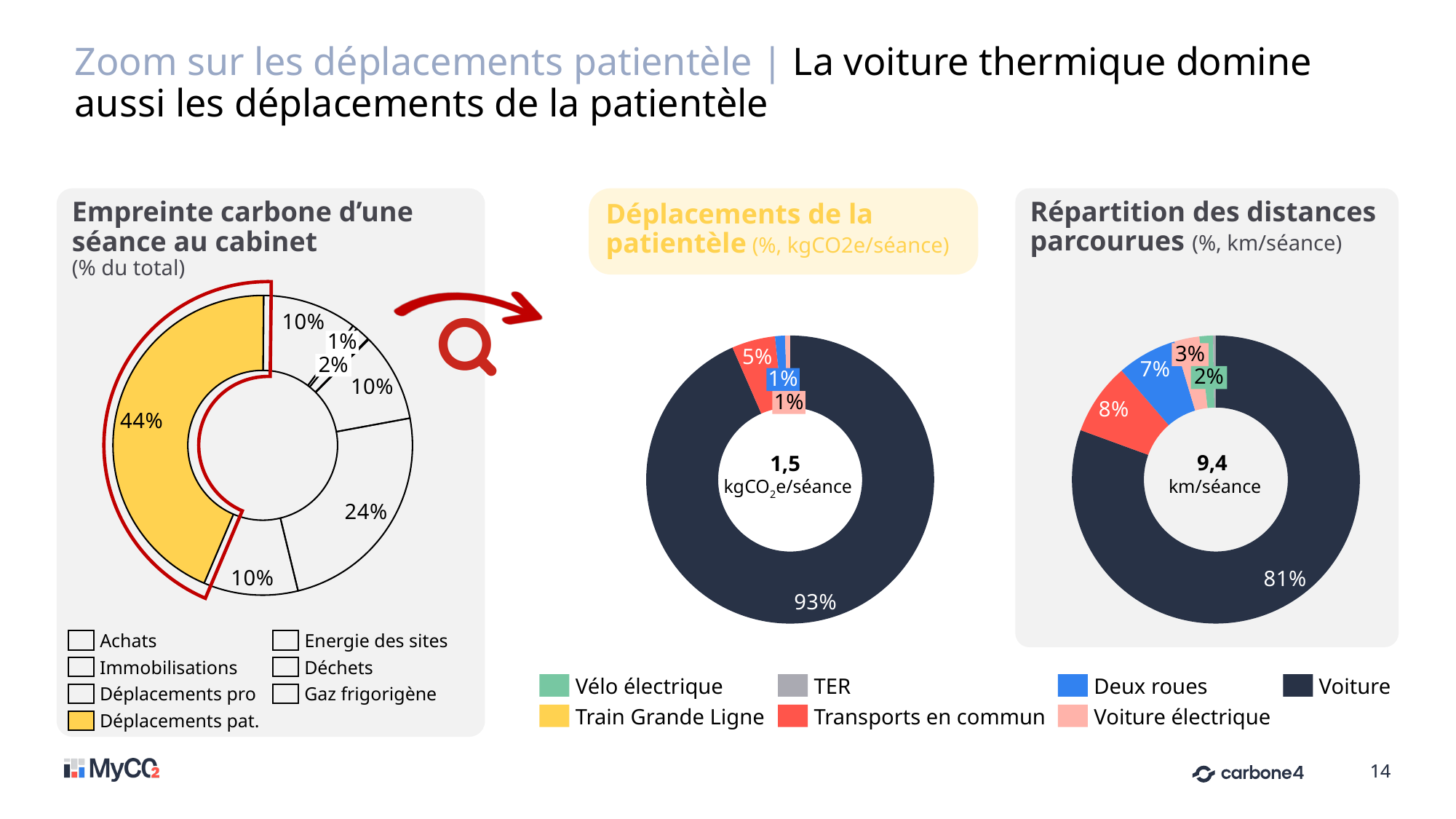
What type of chart is used for 'Répartition des distances parcourues'? Donut (pie) chart In the 'Répartition des distances parcourues' chart, which is larger: 'Transports en commun' or 'Deux roues'? Transports en commun In the 'Répartition des distances parcourues' chart, what is the difference in percentage points between 'Voiture' and 'Transports en commun'? 73 percentage points In the 'Empreinte carbone d'une séance au cabinet' chart, what share of the total is 'Déplacements pat.'? 44% What value is shown in the centre of the 'Déplacements de la patientèle' chart? 1,5 kgCO2e/séance In the 'Déplacements de la patientèle' chart, what percentage is attributed to 'Transports en commun'? 5% In the 'Déplacements de la patientèle' chart, what percentage is attributed to 'Voiture'? 93% In the 'Répartition des distances parcourues' chart, what percentage is attributed to 'Voiture'? 81% In the 'Répartition des distances parcourues' chart, what percentage is attributed to 'Deux roues'? 7% In the 'Empreinte carbone d'une séance au cabinet' chart, what is the value of the largest slice? 44% What value is shown in the centre of the 'Répartition des distances parcourues' chart? 9,4 km/séance How many slices does the 'Empreinte carbone d'une séance au cabinet' donut chart have? 7